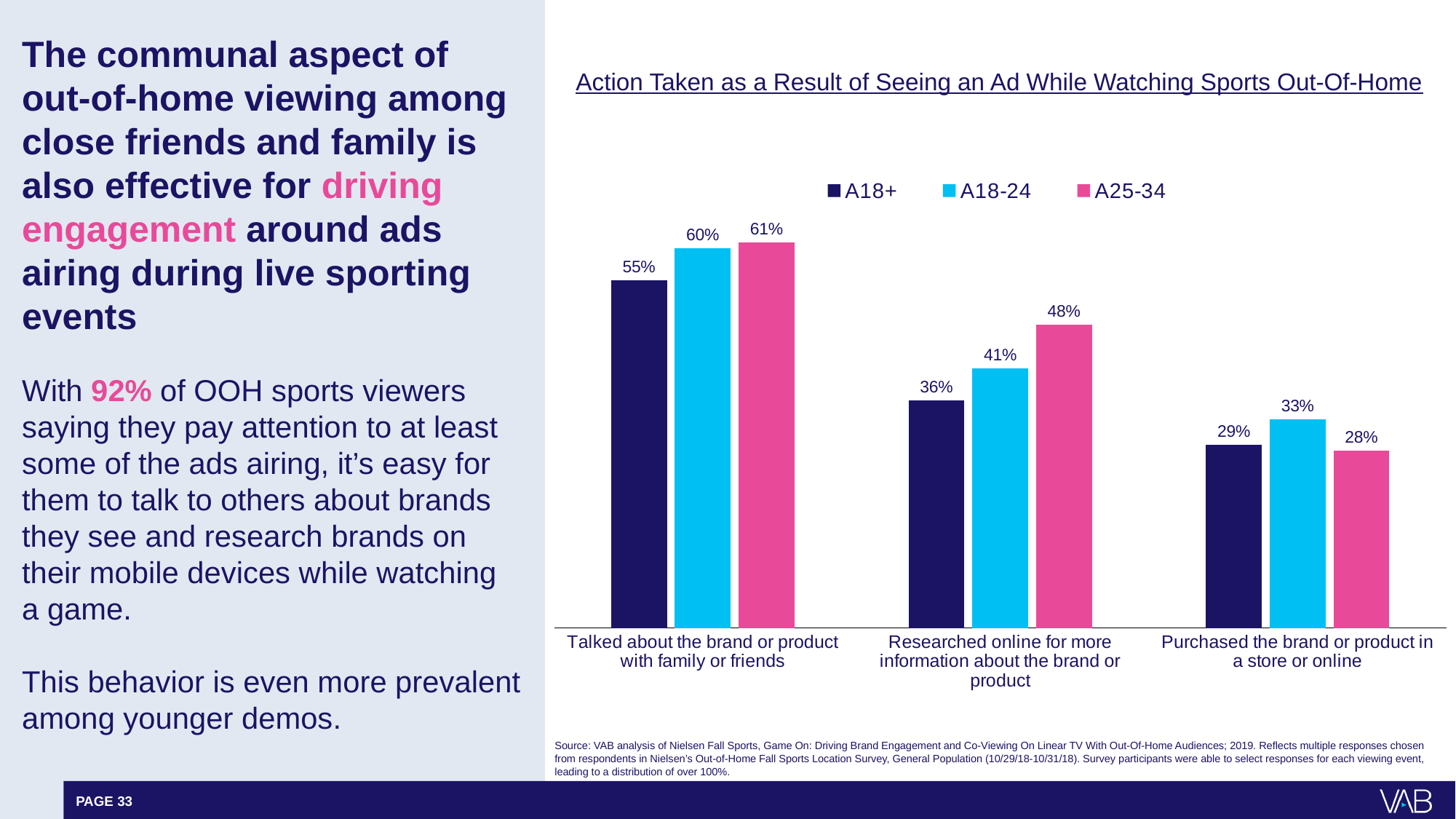
How many categories are shown on the x axis? 3 Which category has the highest value for the A18+ series? Talked about the brand or product with family or friends Do the A18-24 values rise or fall moving from left to right across the categories? Fall What is the title of the chart? Action Taken as a Result of Seeing an Ad While Watching Sports Out-Of-Home What is the value for A25-34 for 'Researched online for more information about the brand or product'? 48% Which category has the lowest value for the A25-34 series? Purchased the brand or product in a store or online What kind of chart is shown on the slide? Bar chart What is the difference between the A25-34 and A18+ values for 'Researched online for more information about the brand or product'? 12% How many series does the legend list? 3 What is the value for A18-24 for 'Purchased the brand or product in a store or online'? 33% What is the value for A18+ for 'Talked about the brand or product with family or friends'? 55% For 'Purchased the brand or product in a store or online', which series has the larger value, A18+ or A18-24? A18-24